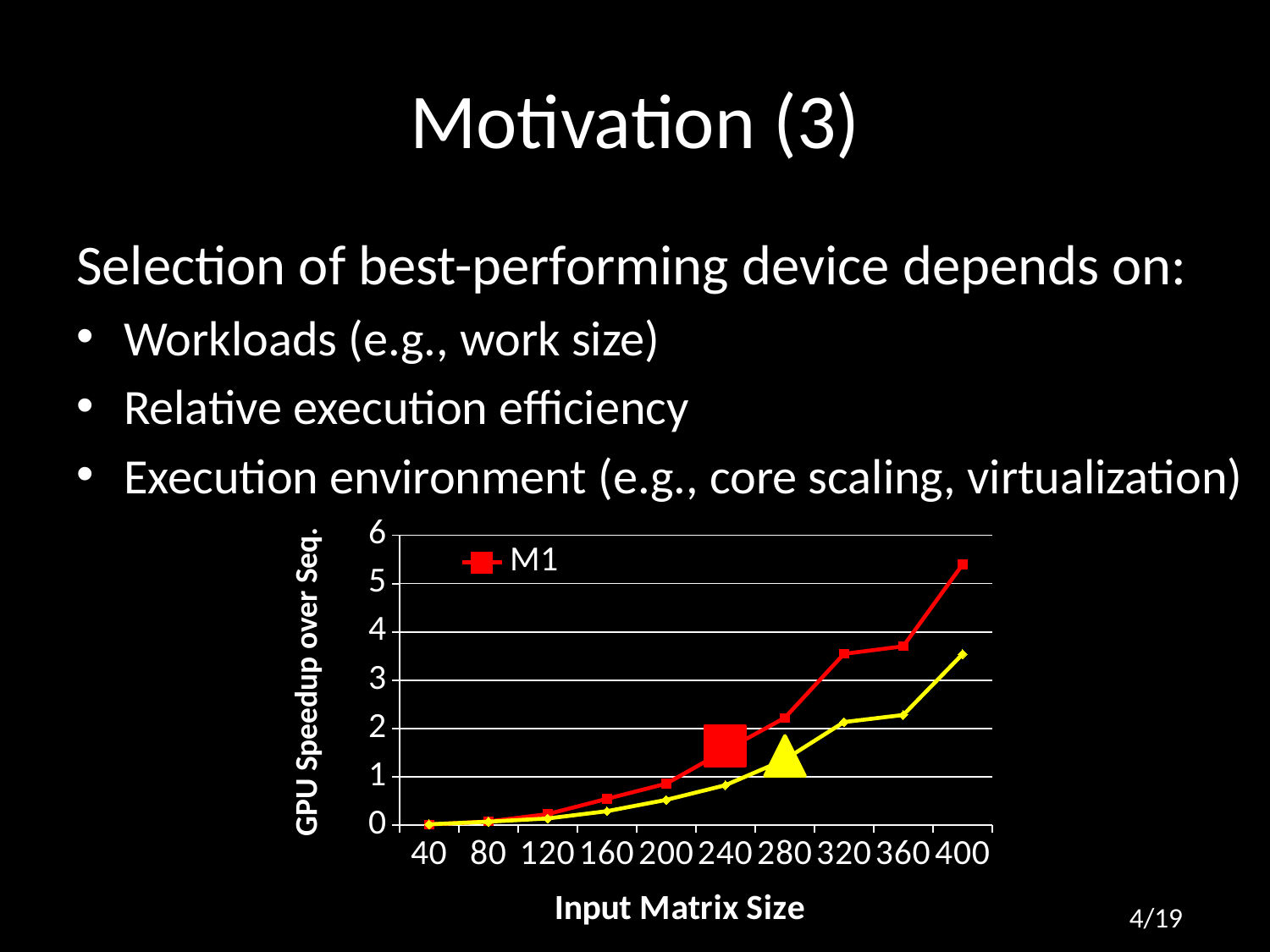
At input matrix size 400, which line is higher, the red M1 line or the yellow line? M1 Is the M1 value at input matrix size 320 greater or less than 3? greater What kind of chart is shown on the slide? line chart Is the yellow line's value at input matrix size 240 greater or less than 1? less How many series does the legend list? 1 Is the M1 value at input matrix size 280 greater or less than 2? greater Does the M1 series rise or fall as the input matrix size increases? rises At which input matrix size does the M1 series reach its highest value? 400 What is the title of the x axis? Input Matrix Size How many input matrix sizes are plotted along the x axis? 10